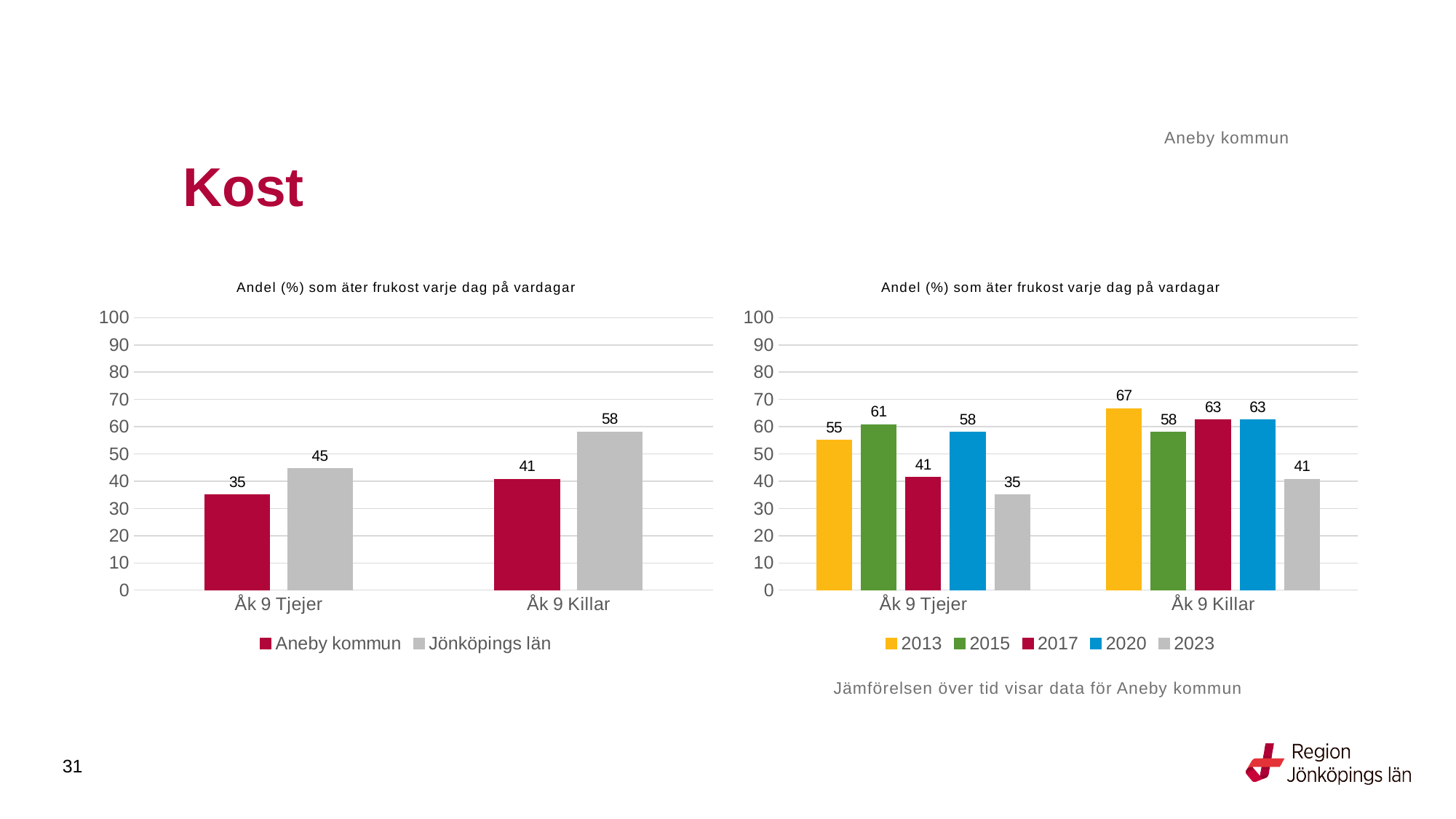
In the left chart, what is the value for Aneby kommun for Åk 9 Tjejer? 35 In the right chart, what is the difference between the 2013 and 2023 values for Åk 9 Killar? 26 In the left chart, which is larger for Åk 9 Tjejer: Aneby kommun or Jönköpings län? Jönköpings län In the left chart, how many series does the legend list? 2 In the right chart, which year has the lowest value for Åk 9 Killar? 2023 In the right chart, which year has the highest value for Åk 9 Tjejer? 2015 In the left chart, what is the difference between Jönköpings län and Aneby kommun for Åk 9 Killar? 17 In the right chart, how many series does the legend list? 5 What kind of chart is the left chart? bar chart In the right chart, what is the value for 2013 for Åk 9 Killar? 67 In the left chart, what is the value for Jönköpings län for Åk 9 Killar? 58 In the right chart, what is the value for 2023 for Åk 9 Tjejer? 35